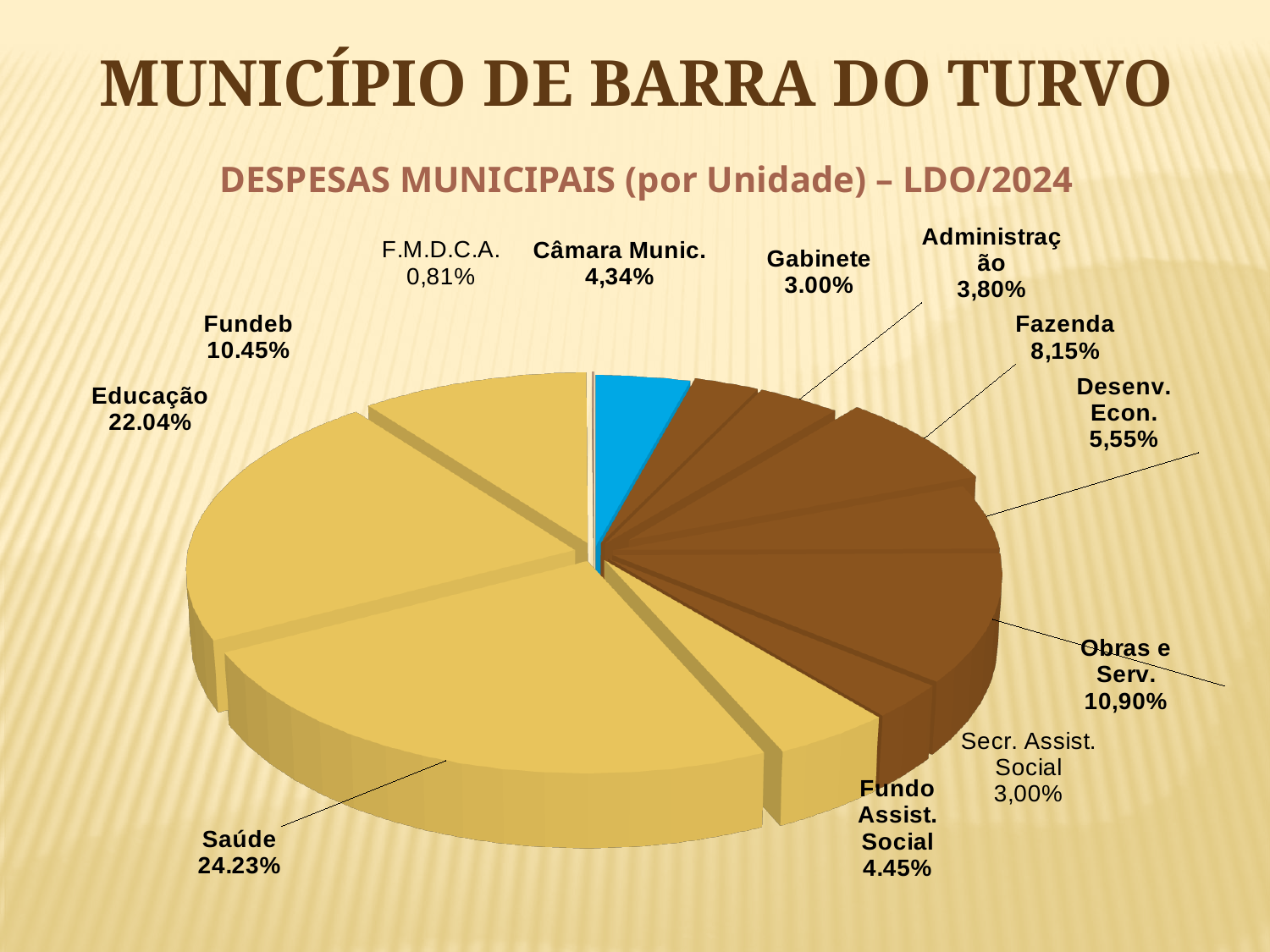
What percentage is shown for Saúde? 24.23% What percentage is shown for Obras e Serv.? 10,90% Which category has the smallest share of the pie? F.M.D.C.A. Which is larger, the share for Educação or the share for Fundeb? Educação Which category has the largest share of the pie? Saúde How many categories (slices) does the pie chart show? 12 What share of the pie does Educação represent? 22.04% What percentage is shown for Fazenda? 8,15% What is the title of the chart? DESPESAS MUNICIPAIS (por Unidade) – LDO/2024 What percentage is shown for Câmara Munic.? 4,34% What type of chart is shown on the slide? Pie chart What is the difference in percentage points between Fazenda (8,15%) and Desenv. Econ. (5,55%)? 2,60